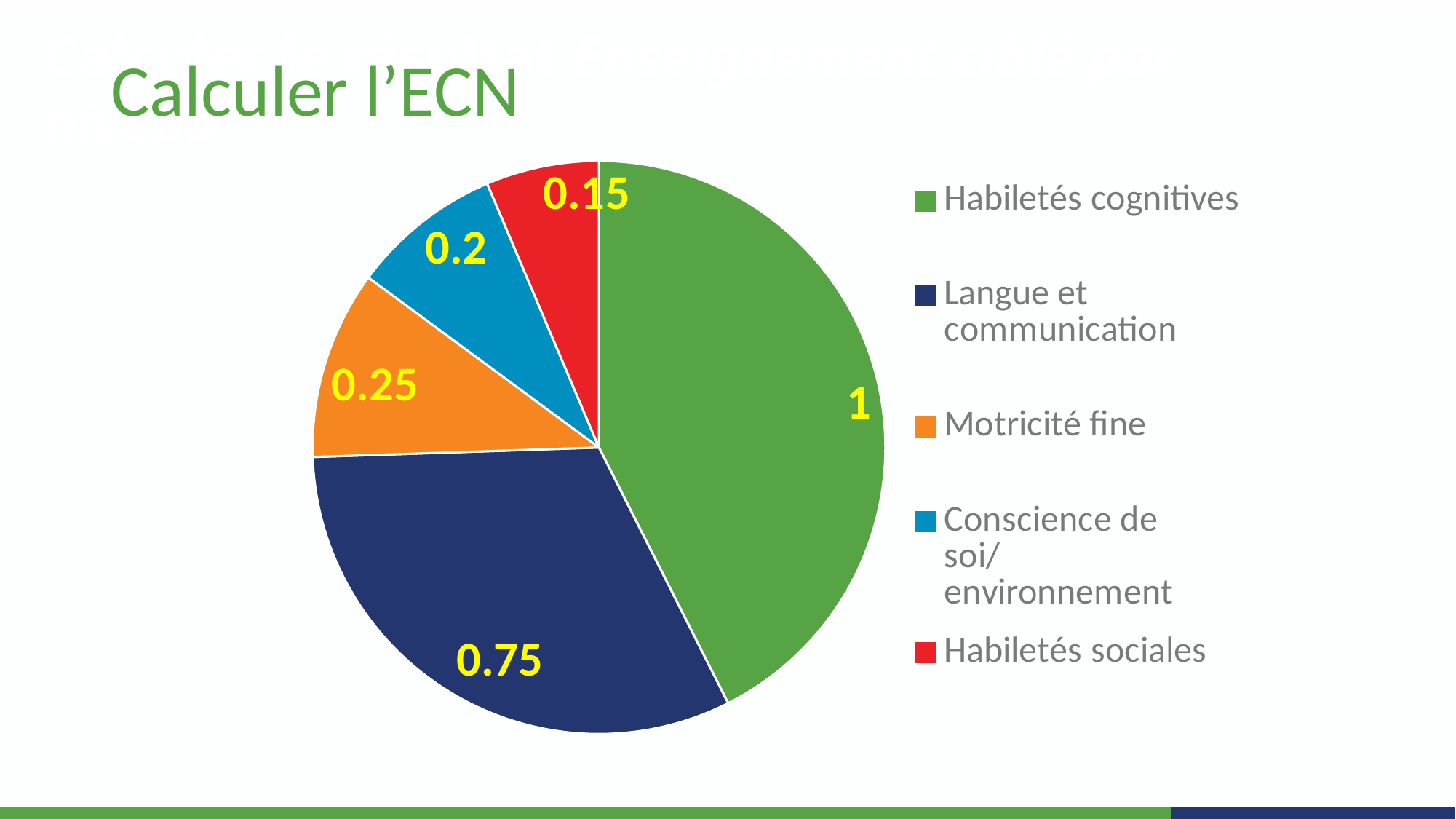
What value is shown for the Conscience de soi/environnement slice? 0.2 Which category has the smallest slice of the pie? Habiletés sociales How many slices does the pie chart have? 5 What value is shown for the Langue et communication slice? 0.75 What is the difference between the values for Habiletés cognitives and Langue et communication? 0.25 What value is shown for the Habiletés cognitives slice? 1 What value is shown for the Habiletés sociales slice? 0.15 Which is larger, the value for Motricité fine or the value for Conscience de soi/environnement? Motricité fine What value is shown for the Motricité fine slice? 0.25 What kind of chart is shown on the slide? Pie chart What colour is the Langue et communication slice? Dark blue Which category has the largest slice of the pie? Habiletés cognitives